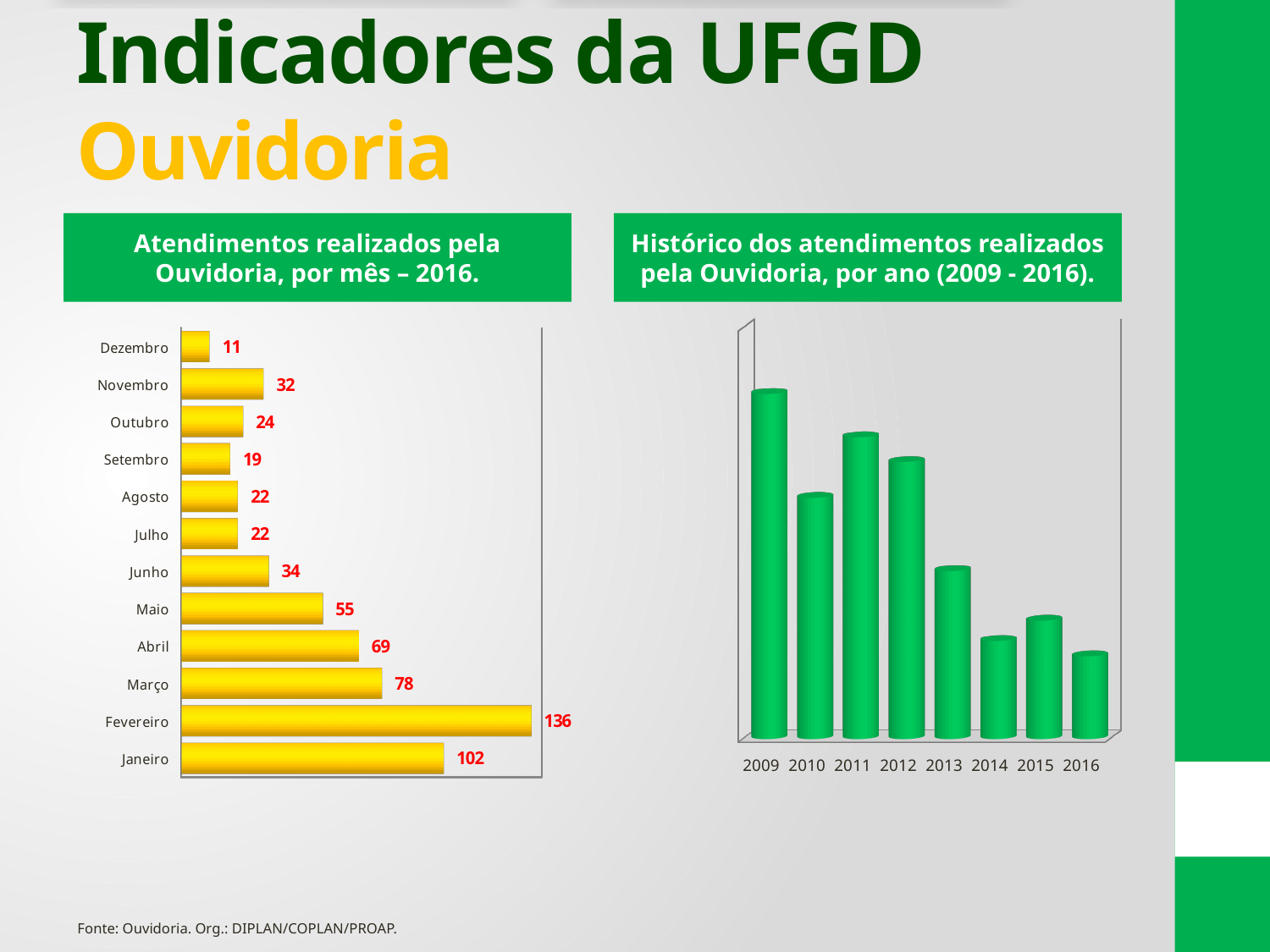
What kind of chart is 'Atendimentos realizados pela Ouvidoria, por mês – 2016'? Bar chart In the chart 'Atendimentos realizados pela Ouvidoria, por mês – 2016', what is the value for Setembro? 19 How many months are shown in the chart 'Atendimentos realizados pela Ouvidoria, por mês – 2016'? 12 In the chart 'Histórico dos atendimentos realizados pela Ouvidoria, por ano (2009 - 2016)', do the values generally rise or fall from 2009 to 2016? Fall In the chart 'Atendimentos realizados pela Ouvidoria, por mês – 2016', which is larger, the value for Maio or the value for Junho? Maio In the chart 'Atendimentos realizados pela Ouvidoria, por mês – 2016', what is the value for Março? 78 In the chart 'Atendimentos realizados pela Ouvidoria, por mês – 2016', what is the difference between the values for Fevereiro and Janeiro? 34 In the chart 'Histórico dos atendimentos realizados pela Ouvidoria, por ano (2009 - 2016)', which is larger, the value for 2010 or the value for 2011? 2011 In the chart 'Histórico dos atendimentos realizados pela Ouvidoria, por ano (2009 - 2016)', which year has the lowest value? 2016 In the chart 'Atendimentos realizados pela Ouvidoria, por mês – 2016', which month has the lowest value? Dezembro In the chart 'Atendimentos realizados pela Ouvidoria, por mês – 2016', which month has the highest value? Fevereiro In the chart 'Histórico dos atendimentos realizados pela Ouvidoria, por ano (2009 - 2016)', which year has the highest value? 2009